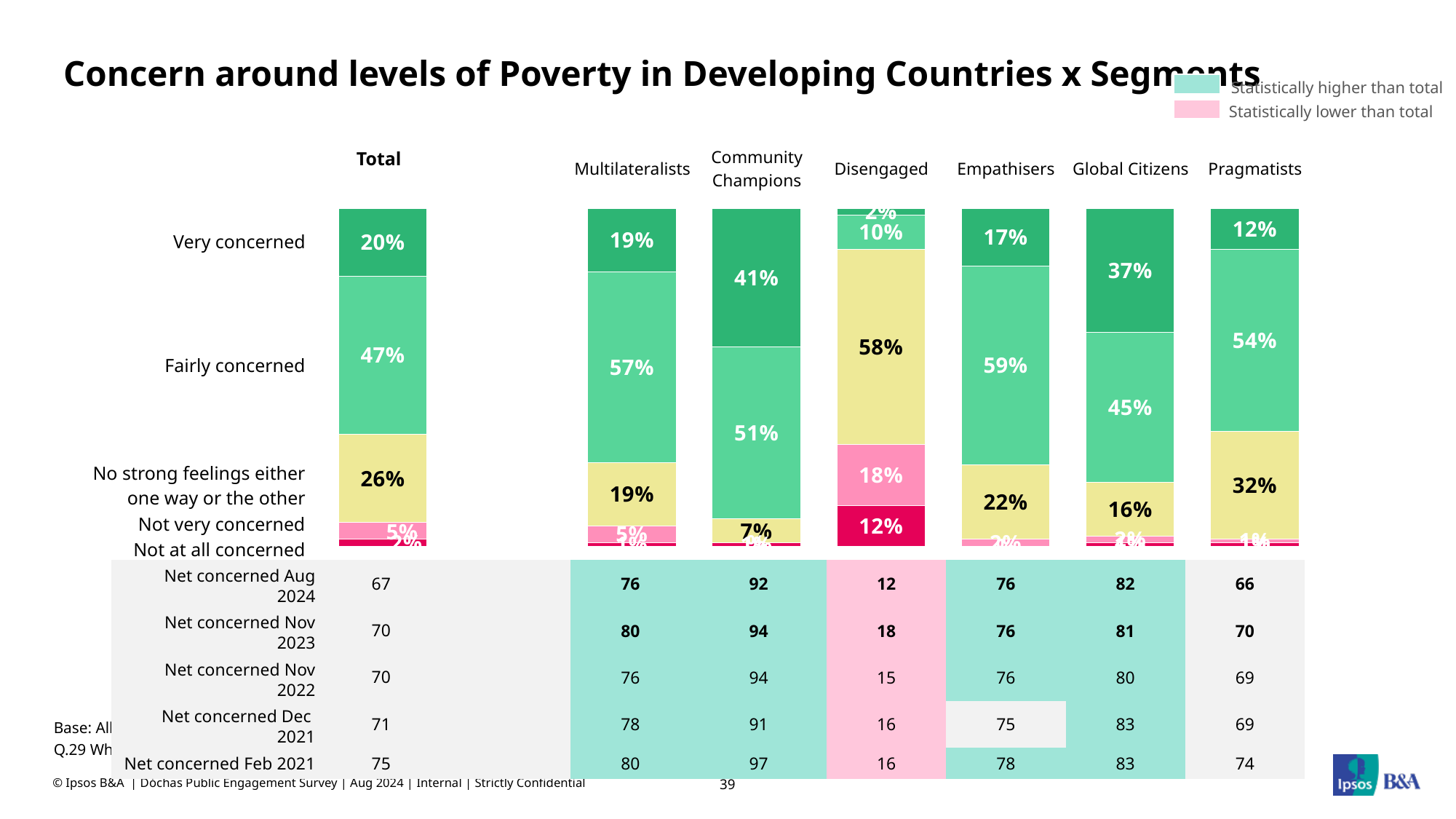
What percentage of the Disengaged segment is Not at all concerned? 12% Which segment has the highest share of Very concerned respondents? Community Champions What percentage of Global Citizens are Very concerned? 37% What percentage of Community Champions are Very concerned? 41% What kind of chart is shown on the slide? Stacked bar chart How many bars (segments including Total) are shown in the chart? 7 What percentage of the Total are Very concerned? 20% Which has a larger share of No strong feelings either one way or the other: Pragmatists or Total? Pragmatists What percentage of Multilateralists are Fairly concerned? 57% What percentage of the Disengaged segment has No strong feelings either one way or the other? 58% How many percentage points higher is the Fairly concerned share for Empathisers than for Pragmatists? 5 percentage points Which segment has the lowest share of Fairly concerned respondents? Disengaged